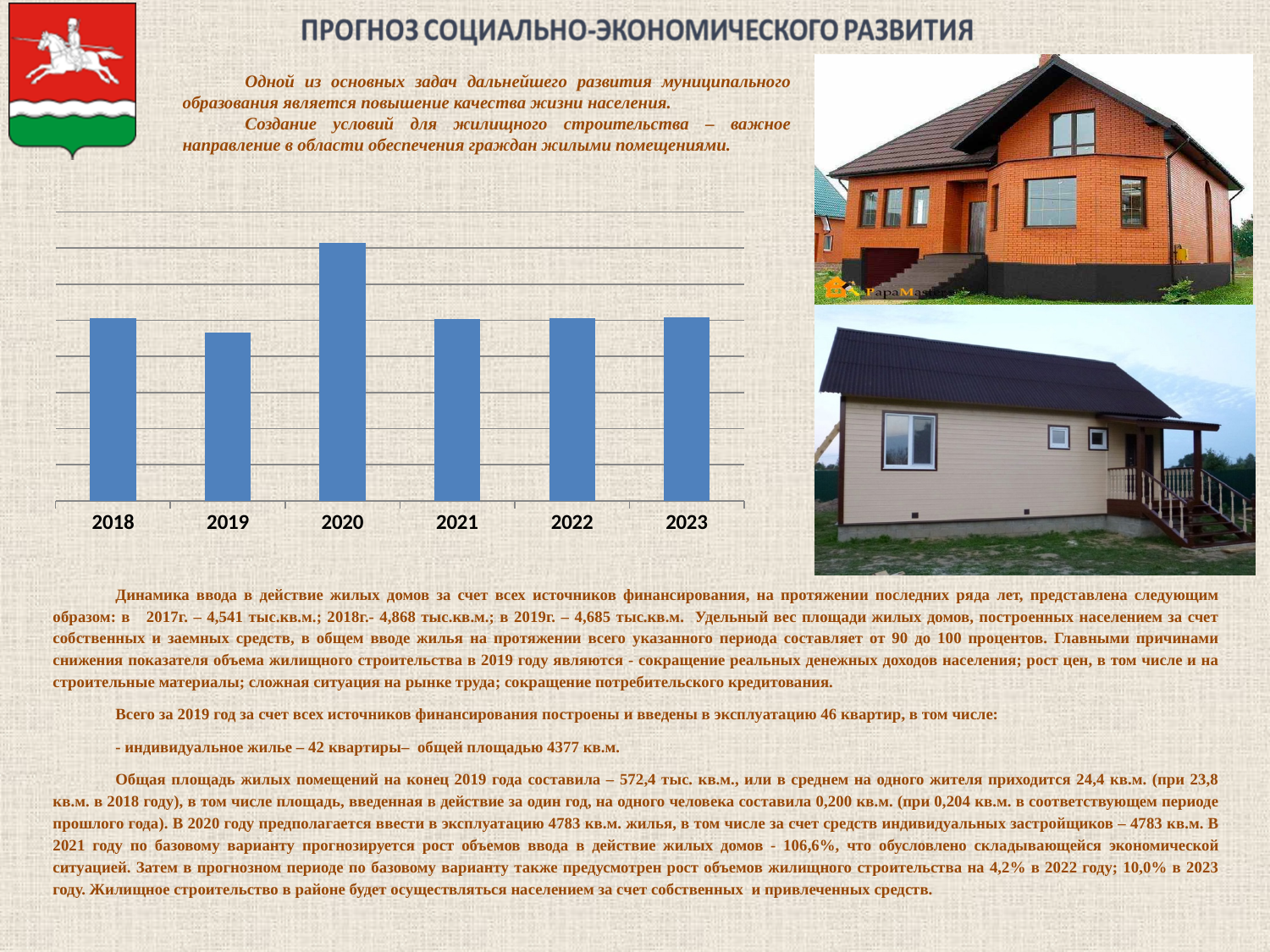
Does the value in the chart rise or fall from 2018 to 2019? fall What colour are the bars in the chart? blue How many categories (years) are shown on the x axis of the chart? 6 What kind of chart is shown on the slide? bar chart Which year has the highest bar in the chart? 2020 Does the value in the chart rise or fall from 2019 to 2020? rise Which year has the larger value in the chart, 2019 or 2020? 2020 Which year has the larger value in the chart, 2018 or 2019? 2018 Which year has the larger value in the chart, 2020 or 2021? 2020 Which year has the lowest bar in the chart? 2019 Does the value in the chart rise or fall from 2020 to 2021? fall What is the first year shown on the x axis of the chart? 2018